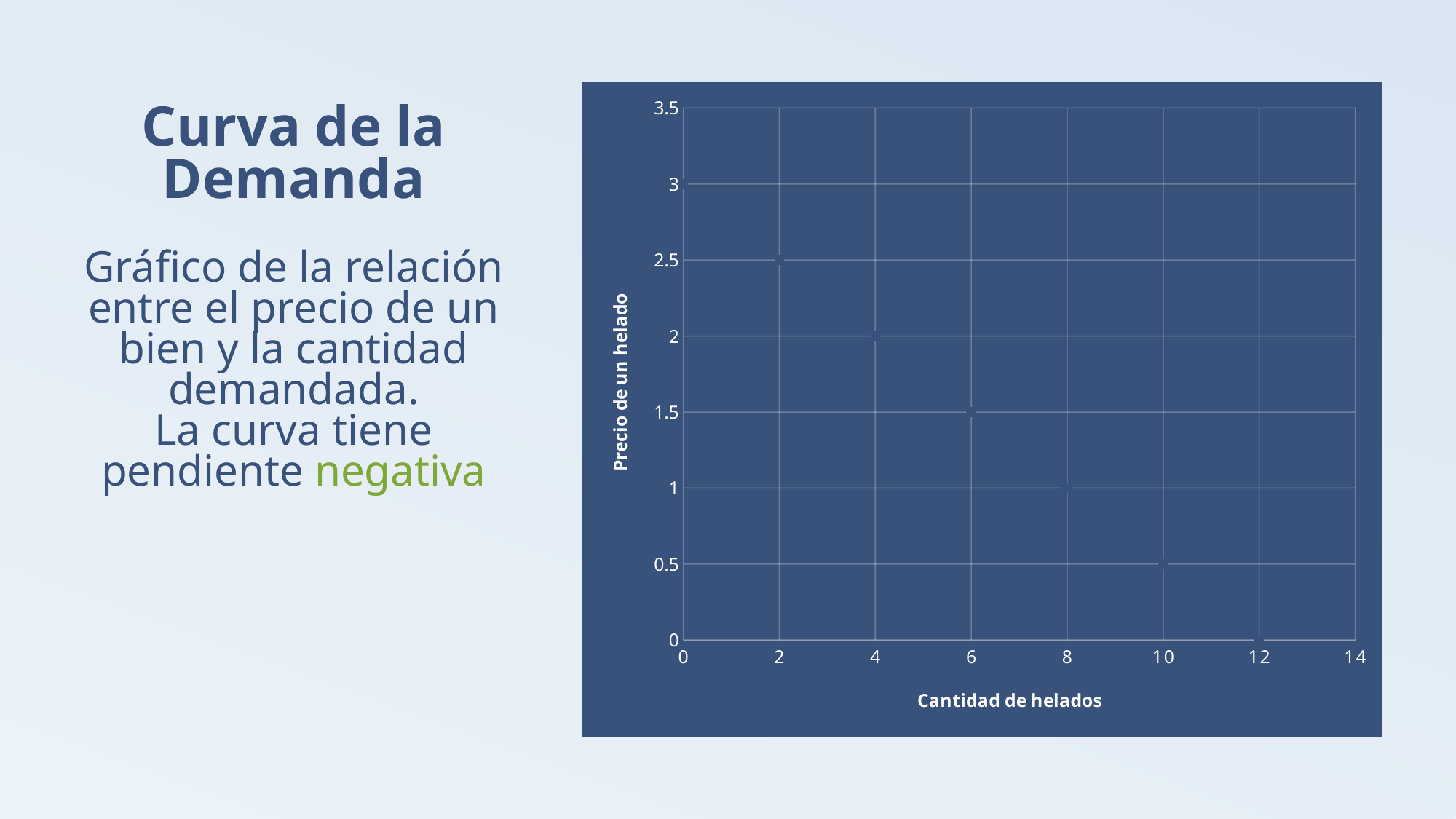
What is the title of the horizontal axis of the chart? Cantidad de helados What is the price of an ice cream when the quantity is 2? 2.5 What kind of chart is shown on the slide? scatter chart Do the plotted values rise or fall as the quantity of ice creams increases along the x axis? fall What is the difference between the price at quantity 2 and the price at quantity 6? 1 How many data points are plotted on the chart? 7 At which quantity is the price lowest? 12 What is the price of an ice cream when the quantity is 12? 0 Which is larger, the price at quantity 4 or the price at quantity 10? quantity 4 At which quantity is the price highest? 0 What is the title of the vertical axis of the chart? Precio de un helado What is the price of an ice cream when the quantity is 8? 1